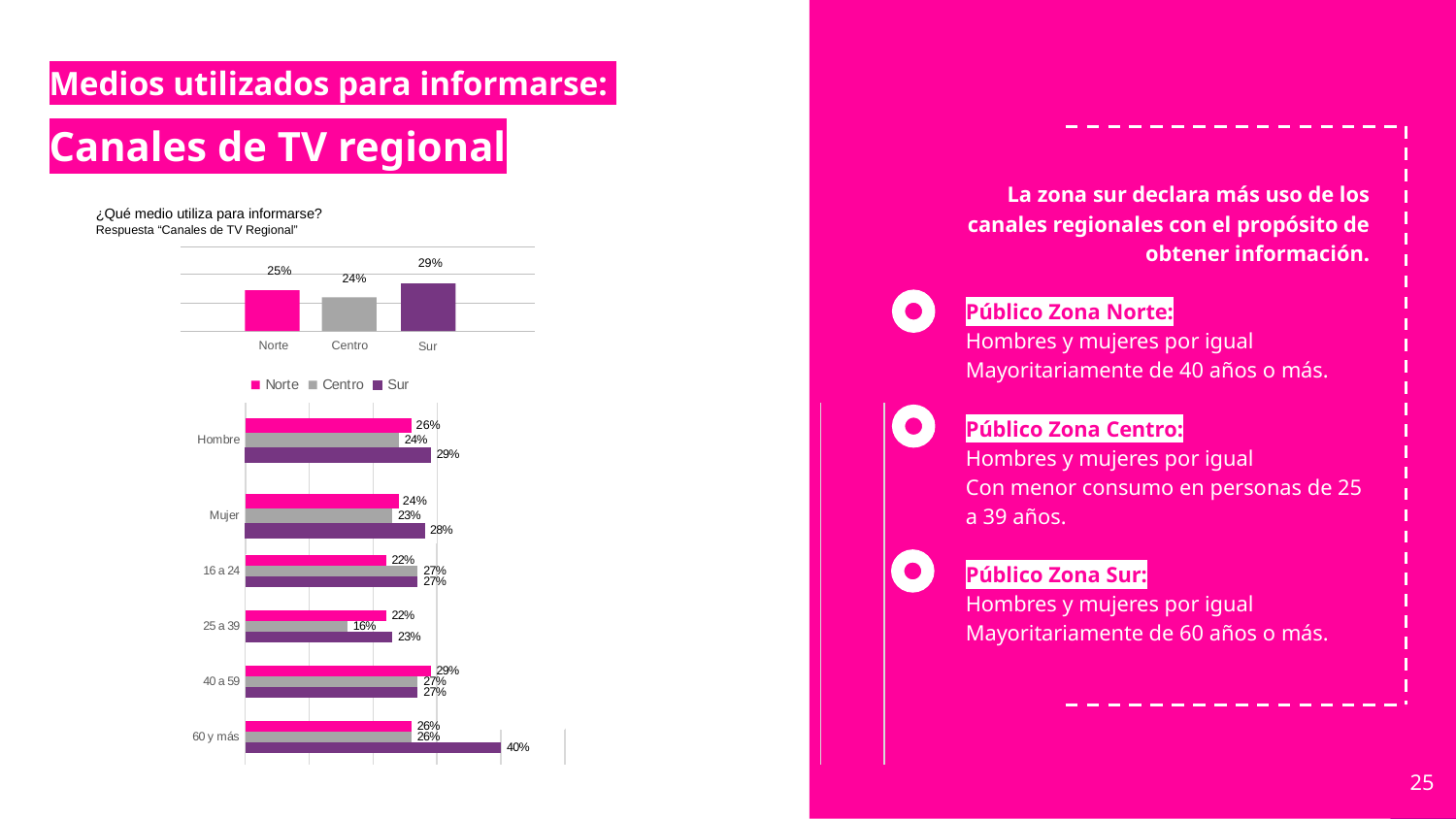
What type of chart is the top chart? Bar chart In the bottom chart, what is the difference between the Sur and Norte values for 60 y más? 14% In the bottom chart, what is the Centro value for 25 a 39? 16% How many series does the legend of the bottom chart list? 3 In the bottom chart, which series is shown in pink? Norte In the top chart, what is the difference between Sur and Norte? 4% In the top chart, what is the value for Sur? 29% In the bottom chart, what is the Sur value for 60 y más? 40% In the bottom chart, which series is larger for Mujer, Norte or Sur? Sur In the bottom chart, what is the Norte value for 40 a 59? 29% How many categories are shown on the bottom chart? 6 In the top chart, which zone has the lowest value? Centro